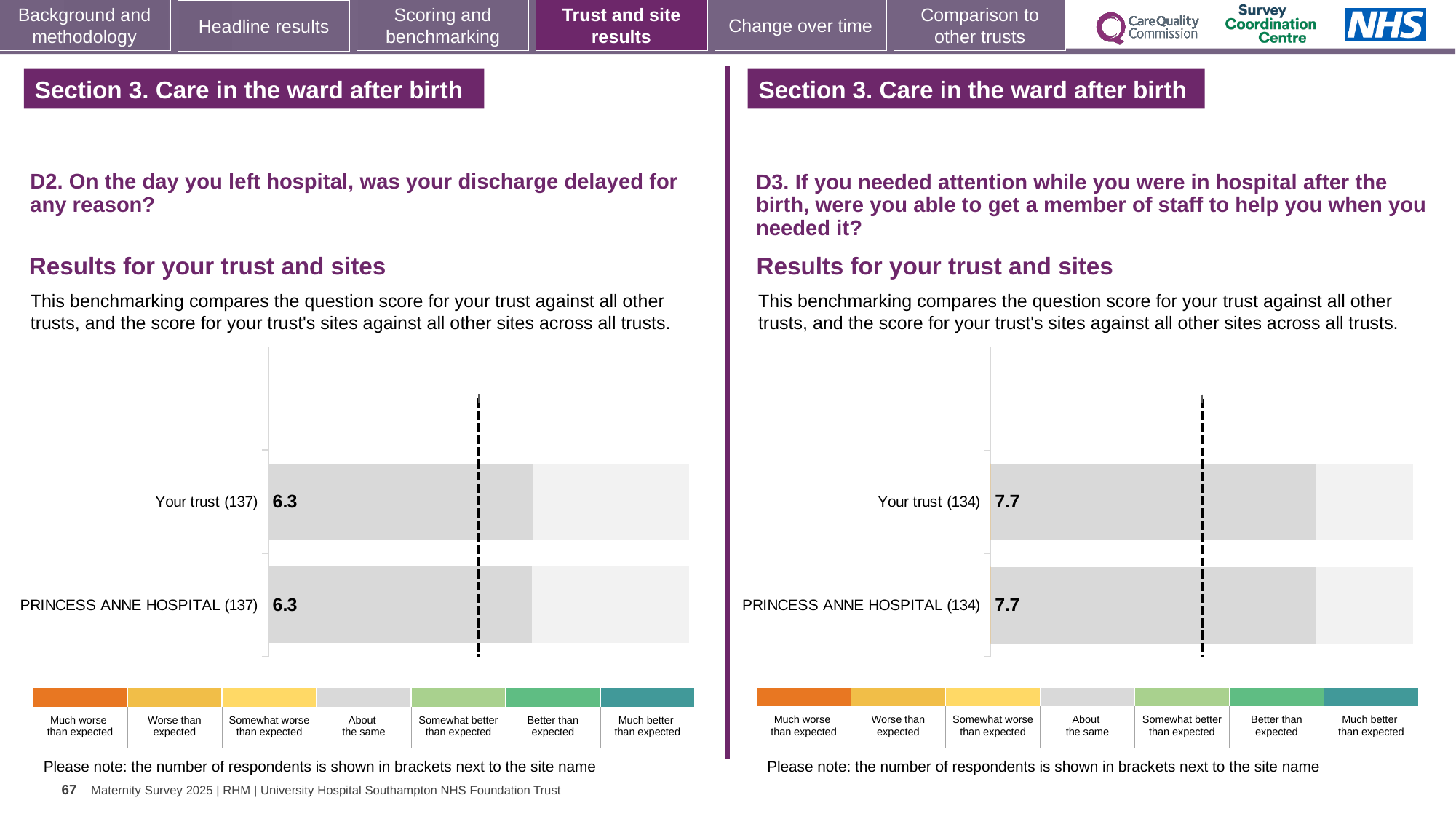
On the left chart (D2), what is the difference between the score for Your trust and the score for PRINCESS ANNE HOSPITAL? 0 What kind of chart is the right chart (D3)? bar chart On the left chart (D2), how many bars are plotted? 2 On the left chart (D2, discharge delayed), what is the score for Your trust? 6.3 On the right chart (D3, able to get a member of staff to help), what is the score for PRINCESS ANNE HOSPITAL? 7.7 Is the score for Your trust higher on the left chart (D2) or on the right chart (D3)? the right chart (D3) On the left chart (D2, discharge delayed), what is the score for PRINCESS ANNE HOSPITAL? 6.3 What is the difference between the Your trust score on the right chart (D3) and the Your trust score on the left chart (D2)? 1.4 On the left chart (D2), how many respondents are shown in brackets next to Your trust? 137 On the right chart (D3), how many bars are plotted? 2 On the right chart (D3, able to get a member of staff to help), what is the score for Your trust? 7.7 On the right chart (D3), how many respondents are shown in brackets next to PRINCESS ANNE HOSPITAL? 134